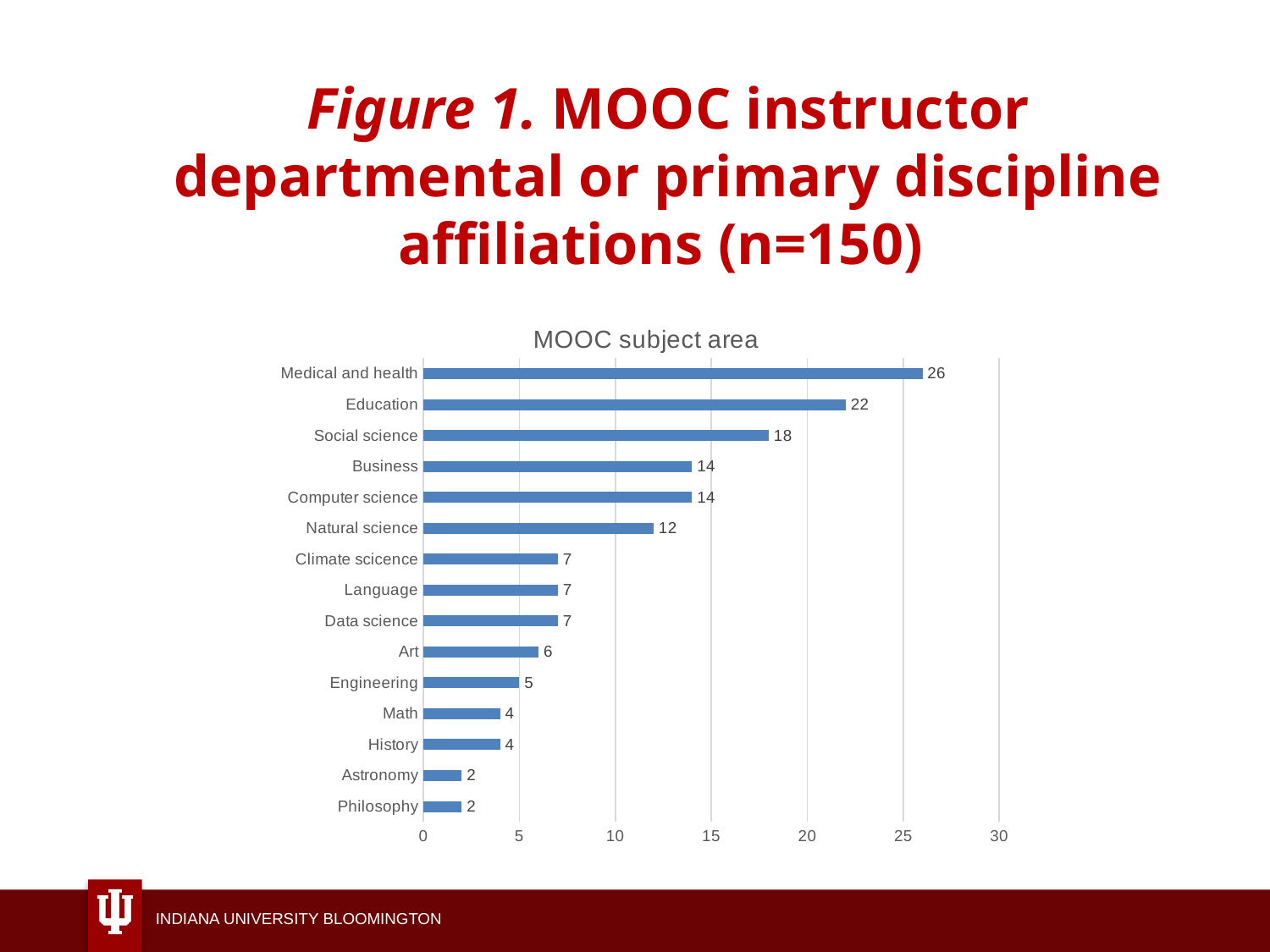
Which category has the highest value? Medical and health What kind of chart is shown on the slide? bar chart How many categories are shown in the chart? 15 What is the value for Engineering? 5 Is the value for Education greater or less than 20? greater What is the title of the chart? MOOC subject area What is the difference between the values for Education and Social science? 4 What is the difference between the values for Medical and health and Philosophy? 24 What is the value for Medical and health? 26 What is the value for Math? 4 Which is larger, the value for Business or the value for Art? Business What is the value for Natural science? 12